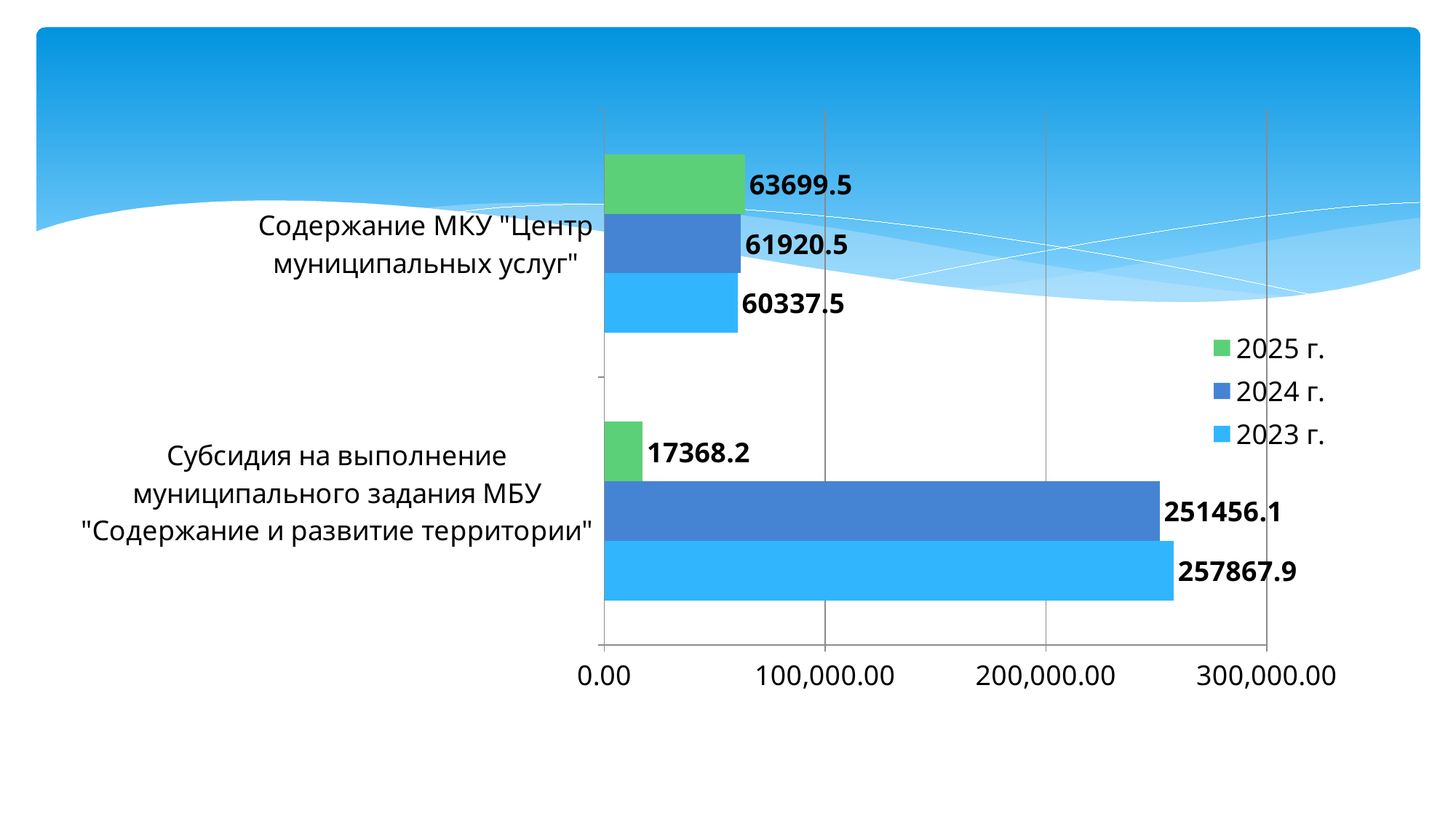
What is the value for 2023 г. for Содержание МКУ "Центр муниципальных услуг"? 60337.5 What is the value for 2023 г. for Субсидия на выполнение муниципального задания МБУ "Содержание и развитие территории"? 257867.9 What kind of chart is shown on the slide? Bar chart What is the difference between the 2023 г. and 2024 г. values for Субсидия на выполнение муниципального задания МБУ "Содержание и развитие территории"? 6411.8 Which year has the highest value for Содержание МКУ "Центр муниципальных услуг"? 2025 г. Which is larger: the 2024 г. value for Содержание МКУ "Центр муниципальных услуг" or the 2025 г. value for Субсидия на выполнение муниципального задания МБУ "Содержание и развитие территории"? 2024 г. value for Содержание МКУ "Центр муниципальных услуг" How many series does the legend list? 3 What is the value for 2025 г. for Содержание МКУ "Центр муниципальных услуг"? 63699.5 What is the difference between the 2025 г. and 2023 г. values for Содержание МКУ "Центр муниципальных услуг"? 3362 Which year has the lowest value for Субсидия на выполнение муниципального задания МБУ "Содержание и развитие территории"? 2025 г. What is the value for 2024 г. for Субсидия на выполнение муниципального задания МБУ "Содержание и развитие территории"? 251456.1 Is the 2023 г. value for Субсидия на выполнение муниципального задания МБУ "Содержание и развитие территории" greater or less than 200,000.00? greater